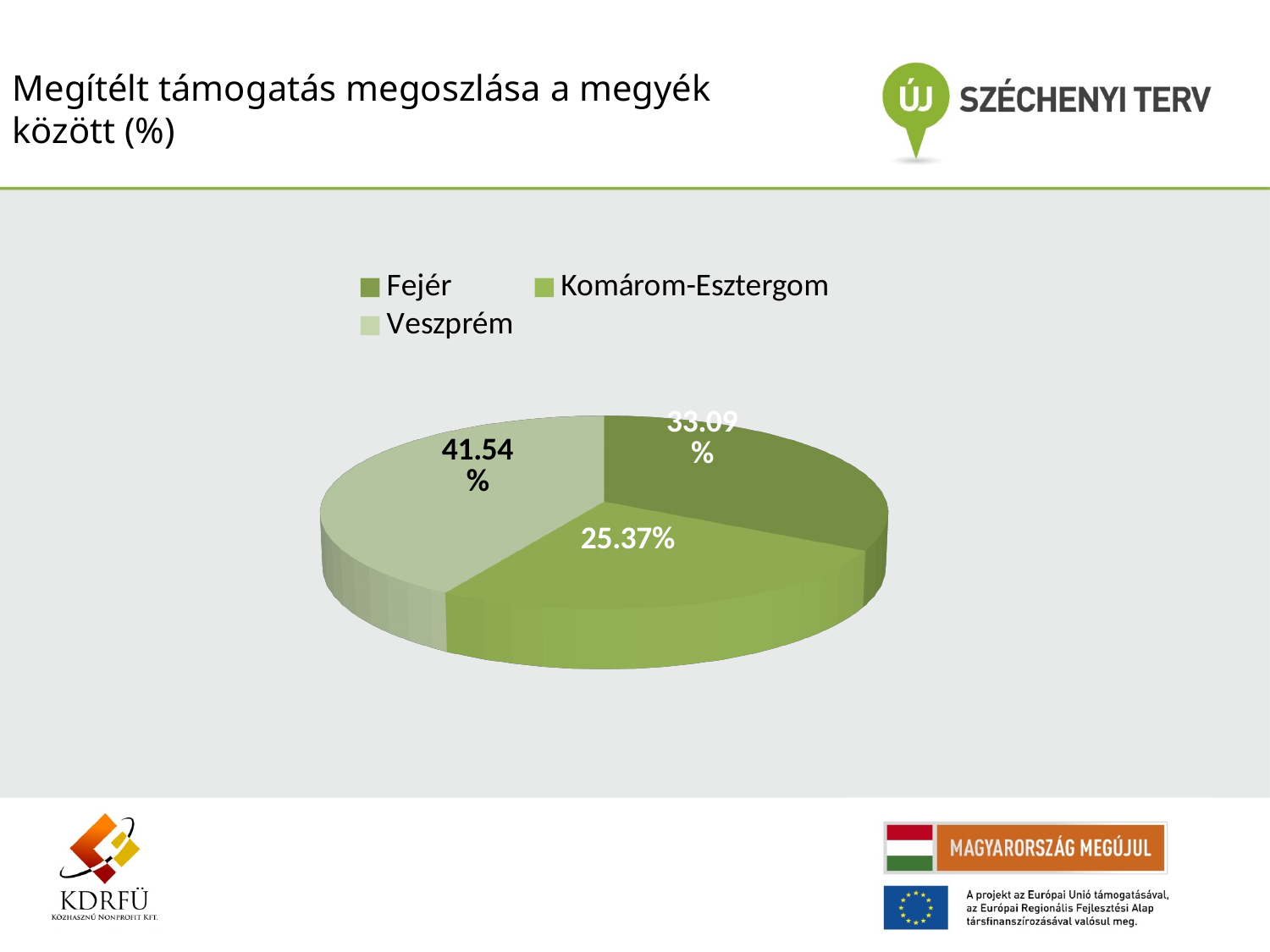
Which county has the smallest share of the pie? Komárom-Esztergom What share of the pie does Fejér have? 33.09% What is the title of the chart on the slide? Megítélt támogatás megoszlása a megyék között (%) What share of the pie does Komárom-Esztergom have? 25.37% How many entries does the legend list? 3 Which is larger, the share for Fejér or the share for Komárom-Esztergom? Fejér What is the difference in percentage points between the Veszprém share and the Fejér share? 8.45 How many slices does the pie chart have? 3 What is the difference in percentage points between the Fejér share and the Komárom-Esztergom share? 7.72 What kind of chart is shown on the slide? pie chart What share of the pie does Veszprém have? 41.54% Which county has the largest share of the pie? Veszprém